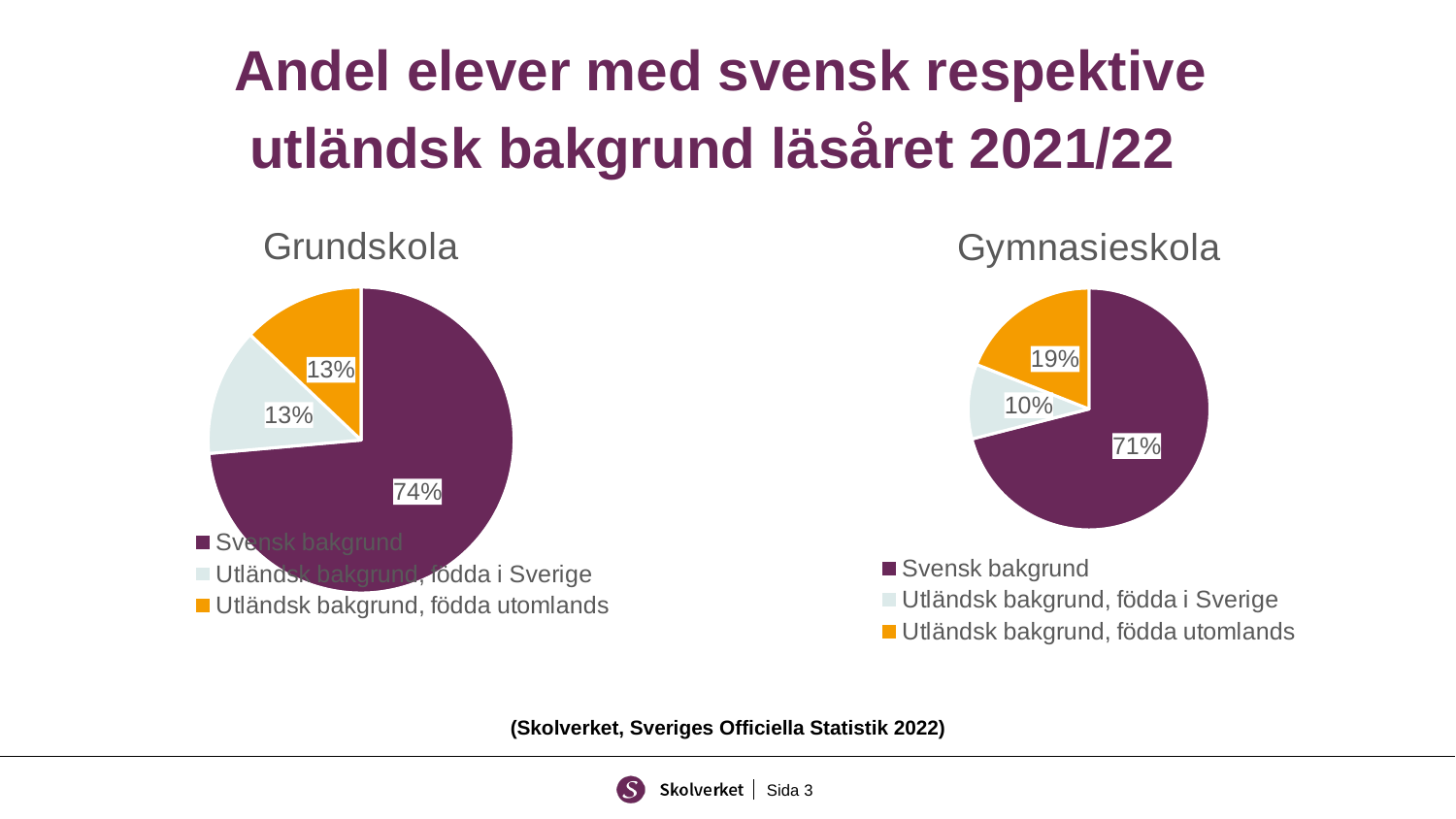
In the Grundskola chart, what share of pupils have Svensk bakgrund? 74% In the Gymnasieskola chart, what share of pupils are Utländsk bakgrund, födda i Sverige? 10% In the Gymnasieskola chart, what share of pupils have Svensk bakgrund? 71% Which chart shows a larger share for Utländsk bakgrund, födda utomlands, Grundskola or Gymnasieskola? Gymnasieskola In the Grundskola chart, what share of pupils are Utländsk bakgrund, födda utomlands? 13% In the Gymnasieskola chart, what is the difference between the Utländsk bakgrund, födda utomlands share and the Utländsk bakgrund, födda i Sverige share? 9 percentage points What is the difference between the Svensk bakgrund share in the Grundskola chart and in the Gymnasieskola chart? 3 percentage points In the Gymnasieskola chart, what share of pupils are Utländsk bakgrund, födda utomlands? 19% How many categories does the legend of the Gymnasieskola chart list? 3 In the Gymnasieskola chart, which category has the smallest share? Utländsk bakgrund, födda i Sverige What type of chart is used for the Grundskola data? Pie chart In the Gymnasieskola chart, which category has the largest share? Svensk bakgrund